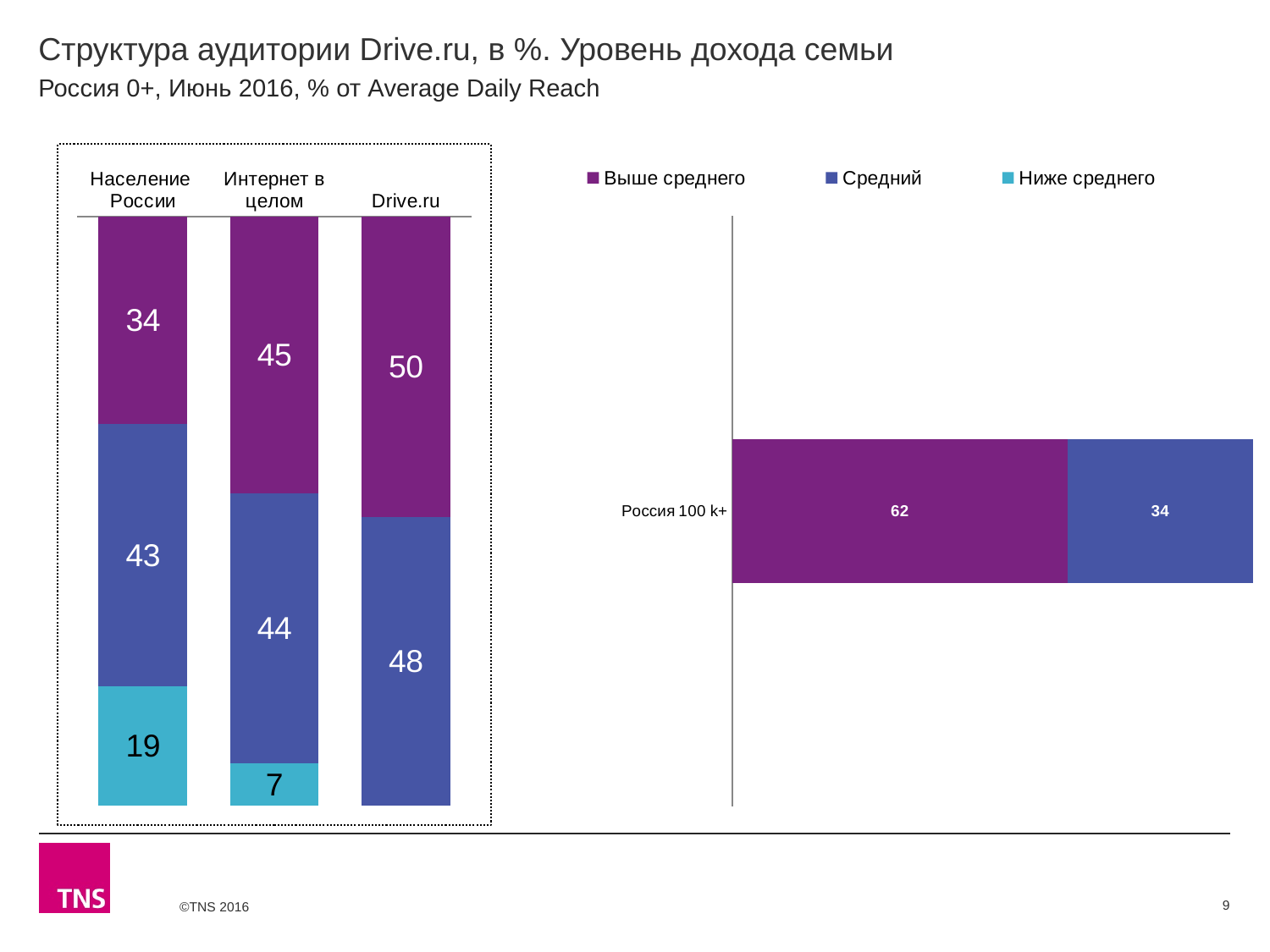
How many series does the legend list? 3 On the left chart, which category has the highest 'Выше среднего' value? Drive.ru On the left chart, what is the difference between the 'Выше среднего' values for Drive.ru and 'Население России'? 16 How many categories are shown on the left chart? 3 On the left chart, what is the value of the 'Ниже среднего' segment for 'Население России'? 19 On the right chart, what is the total of the two labelled segments for 'Россия 100 k+'? 96 On the left chart, what is the value of the 'Средний' segment for 'Интернет в целом'? 44 What kind of chart is the left chart? Stacked bar chart On the right chart, what is the 'Выше среднего' value for 'Россия 100 k+'? 62 On the left chart, what is the value of the 'Выше среднего' segment for Drive.ru? 50 On the left chart, which is larger: the 'Средний' value for 'Население России' or for Drive.ru? Drive.ru